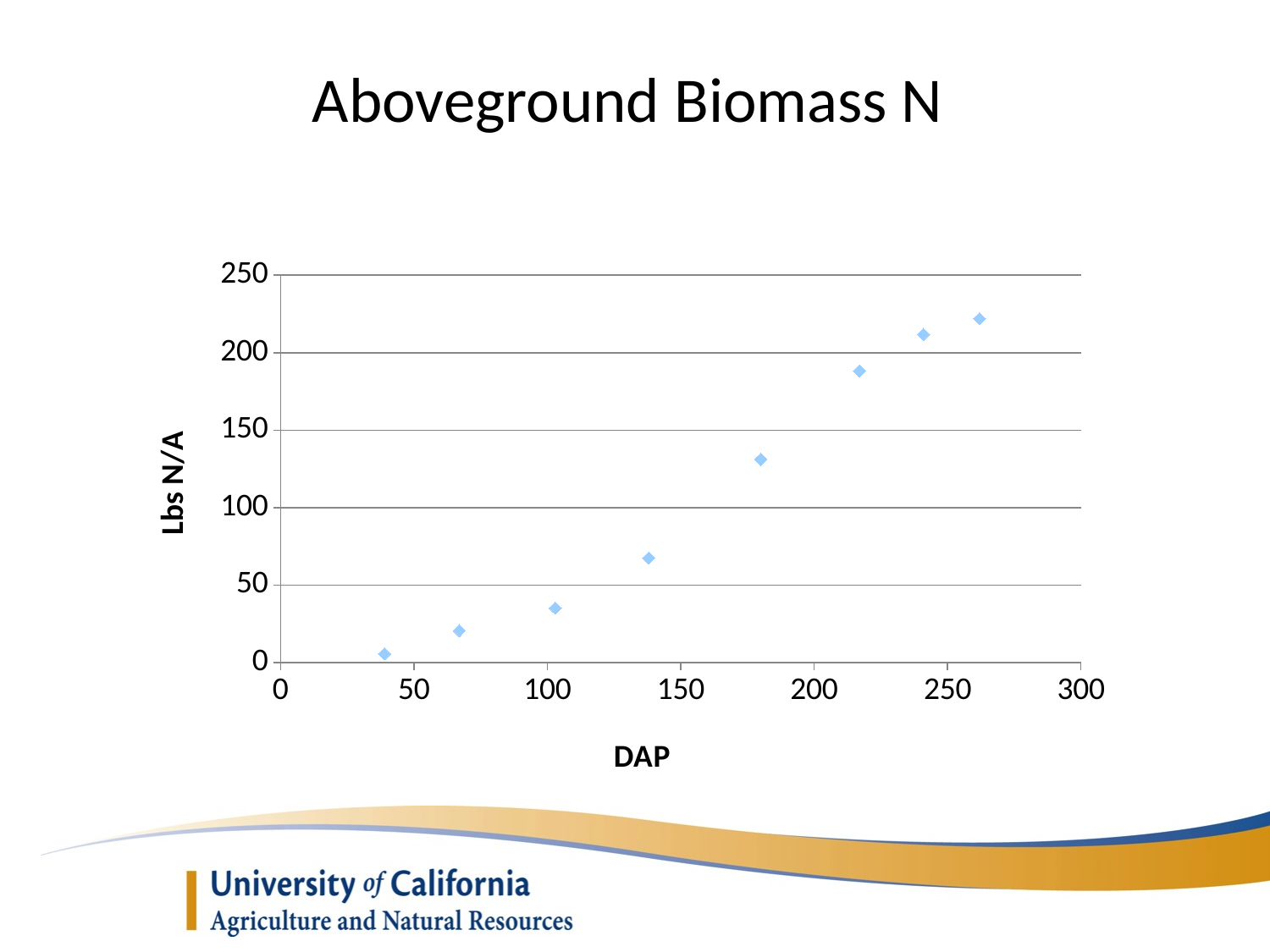
Is the value for the point at about 100 DAP greater or less than 50 Lbs N/A? less Is the value for the point at about 140 DAP greater or less than 100 Lbs N/A? less What is the maximum value shown on the vertical axis? 250 What kind of chart is shown on the slide? scatter chart What is the label on the vertical axis? Lbs N/A Is the value for the point at about 180 DAP greater or less than 100 Lbs N/A? greater Which point has the highest Lbs N/A value, the one at about 40 DAP or the one at about 260 DAP? the one at about 260 DAP Do the values of Lbs N/A rise or fall as DAP increases? rise What is the title of the chart? Aboveground Biomass N How many data points are plotted on the chart? 8